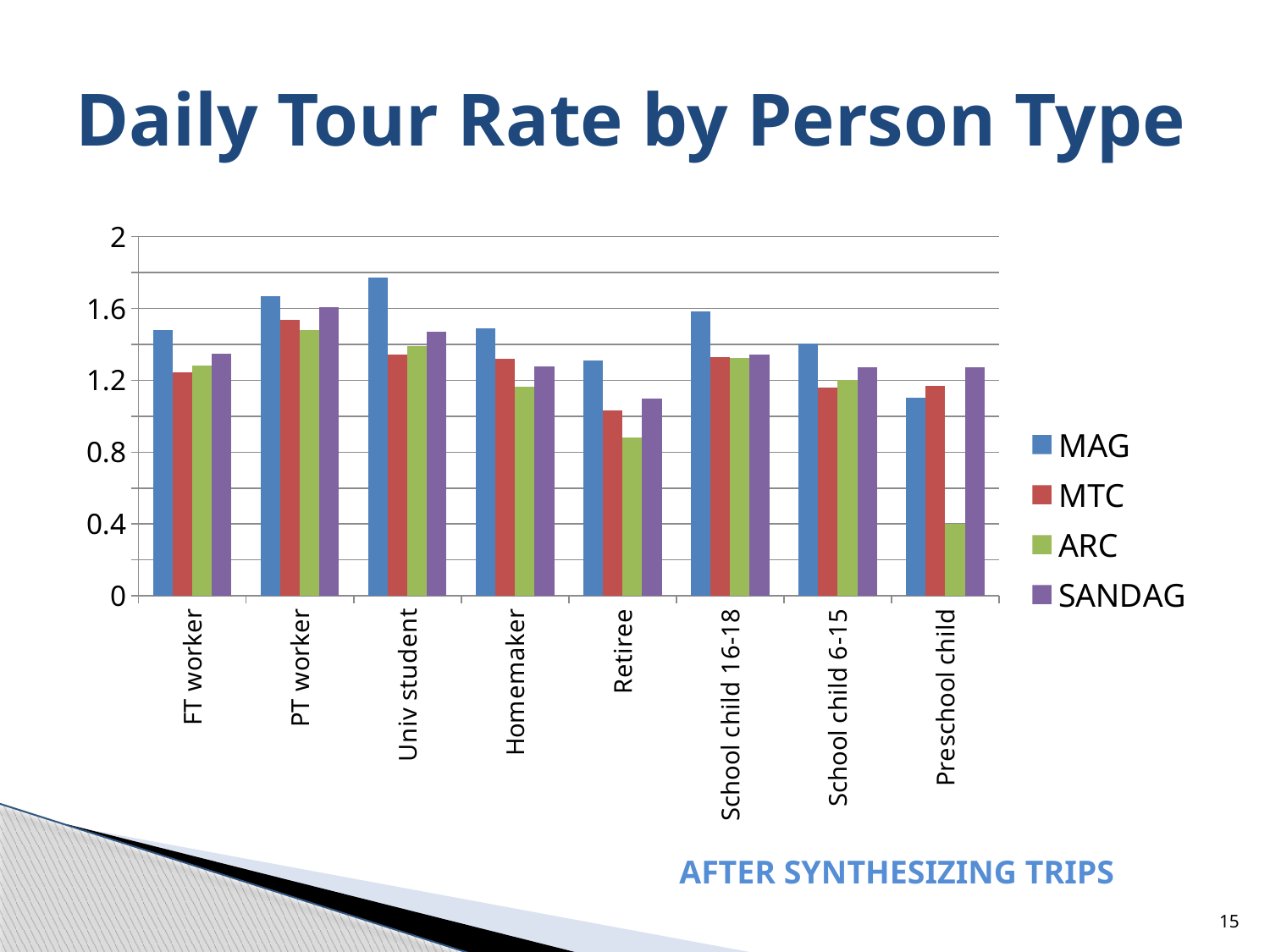
Which person type has the lowest MAG value? Preschool child How many person types are shown on the x axis of the chart? 8 Which person type has the lowest ARC value? Preschool child Is the MTC value for PT worker greater or less than 1.2? greater Is the MAG value for Univ student greater or less than 1.6? greater What kind of chart is shown on the slide? bar chart Is the ARC value for Preschool child greater or less than 0.8? less For FT worker, which is larger: the MAG value or the MTC value? MAG How many series does the chart's legend list? 4 What are the four series listed in the chart's legend? MAG, MTC, ARC, SANDAG Which person type has the highest MAG value? Univ student